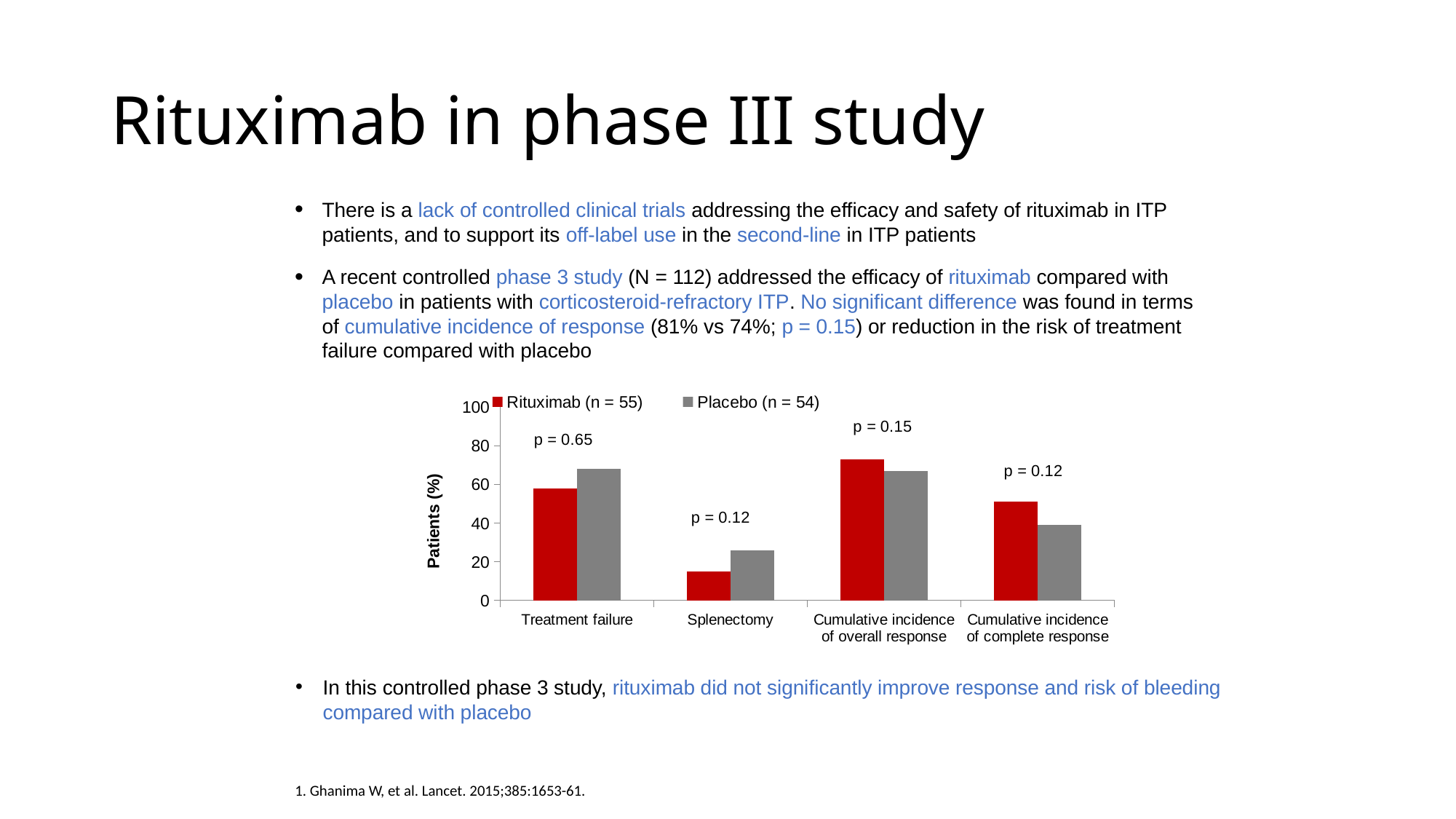
Which category has the highest Rituximab bar? Cumulative incidence of overall response For Cumulative incidence of overall response, which is larger: the Rituximab bar or the Placebo bar? Rituximab Is the Rituximab value for Cumulative incidence of complete response greater or less than 40? greater How many series does the chart legend list? 2 Which category has the lowest Placebo bar? Splenectomy What kind of chart is shown on the slide? Bar chart For Splenectomy, which is larger: the Rituximab bar or the Placebo bar? Placebo For Treatment failure, which is larger: the Rituximab bar or the Placebo bar? Placebo Is the Placebo value for Treatment failure greater or less than 60? greater How many categories are shown along the x axis of the chart? 4 Is the Rituximab value for Splenectomy greater or less than 20? less